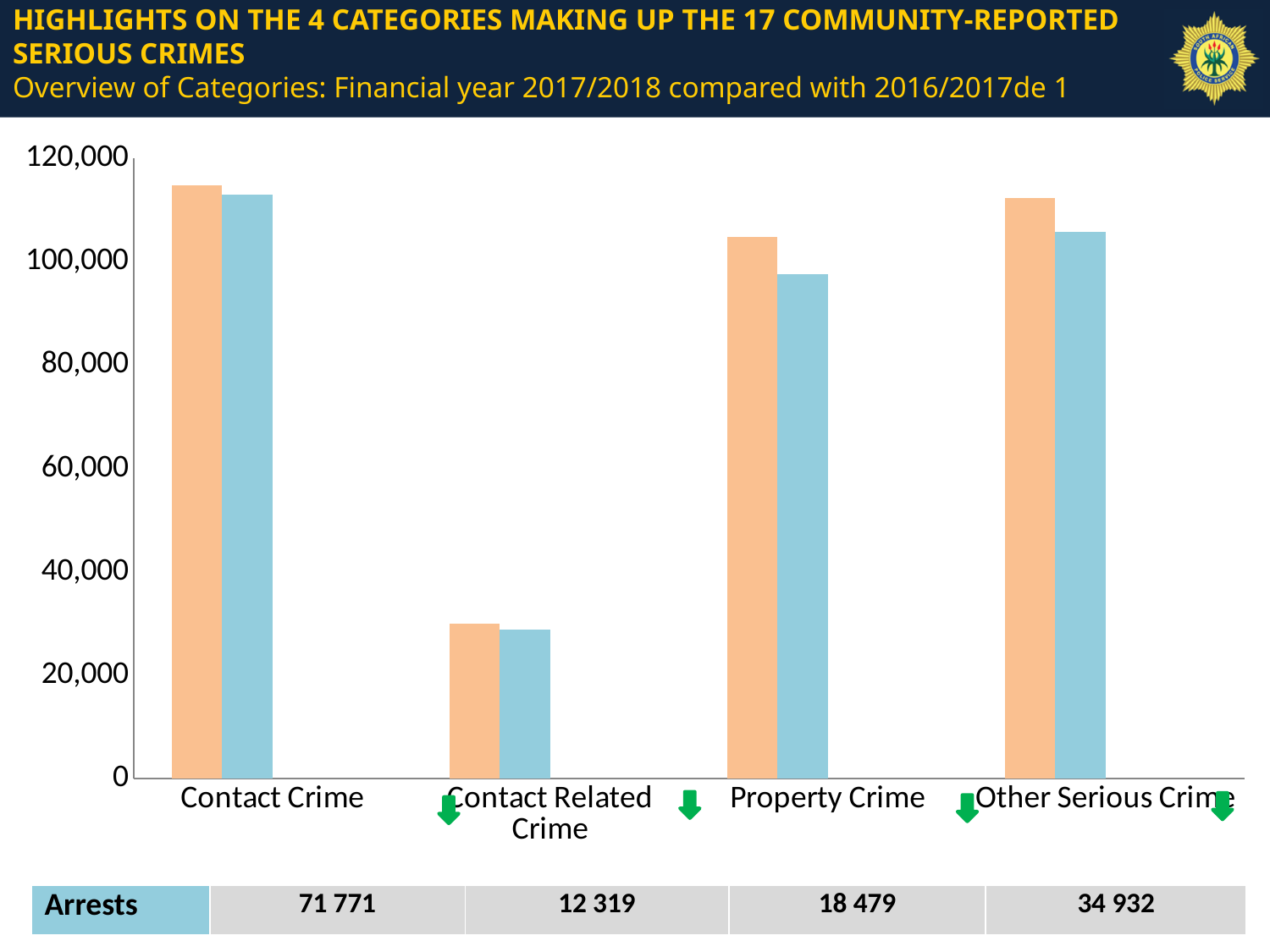
How many crime categories are shown on the x axis of the chart? 4 Which category has the tallest right-hand (blue) bar in the chart? Contact Crime Is the value of the left-hand (orange) bar for Contact Related Crime greater or less than 40,000? less Is the value of the right-hand (blue) bar for Other Serious Crime greater or less than 100,000? greater Is the value of the right-hand (blue) bar for Property Crime greater or less than 100,000? less Which category has a taller left-hand (orange) bar, Contact Crime or Property Crime? Contact Crime How many bars are plotted for each category in the chart? 2 Which category has the lowest bars in the chart? Contact Related Crime What kind of chart is shown on the slide? bar chart What is the highest value shown on the chart's vertical axis? 120,000 For Property Crime, which bar is taller, the left-hand (orange) bar or the right-hand (blue) bar? the left-hand (orange) bar